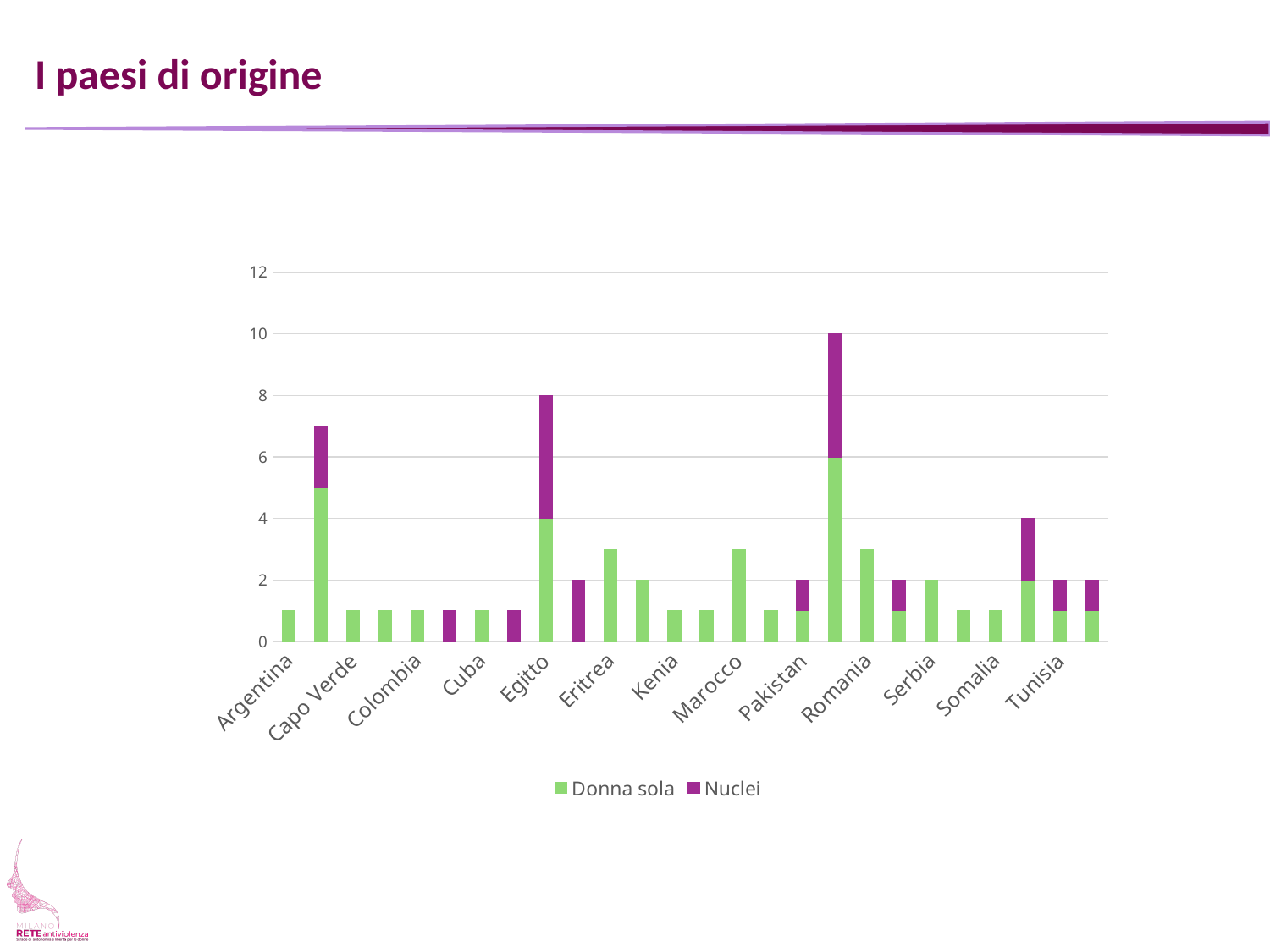
Which has the taller stacked bar, Egitto or Romania? Egitto What is the total height of the stacked bar for Egitto? 8 Is the value for Eritrea greater or less than 2? greater What are the two series named in the legend? Donna sola and Nuclei What is the Donna sola value for Serbia? 2 Which colour represents the Nuclei series? purple What is the Donna sola value for Egitto? 4 How many series does the legend list? 2 What is the total height of the stacked bar for Pakistan? 2 What kind of chart is shown on the slide? bar chart Is the value for Argentina greater or less than 2? less Among the countries whose names are labelled on the x axis, which has the tallest stacked bar? Egitto